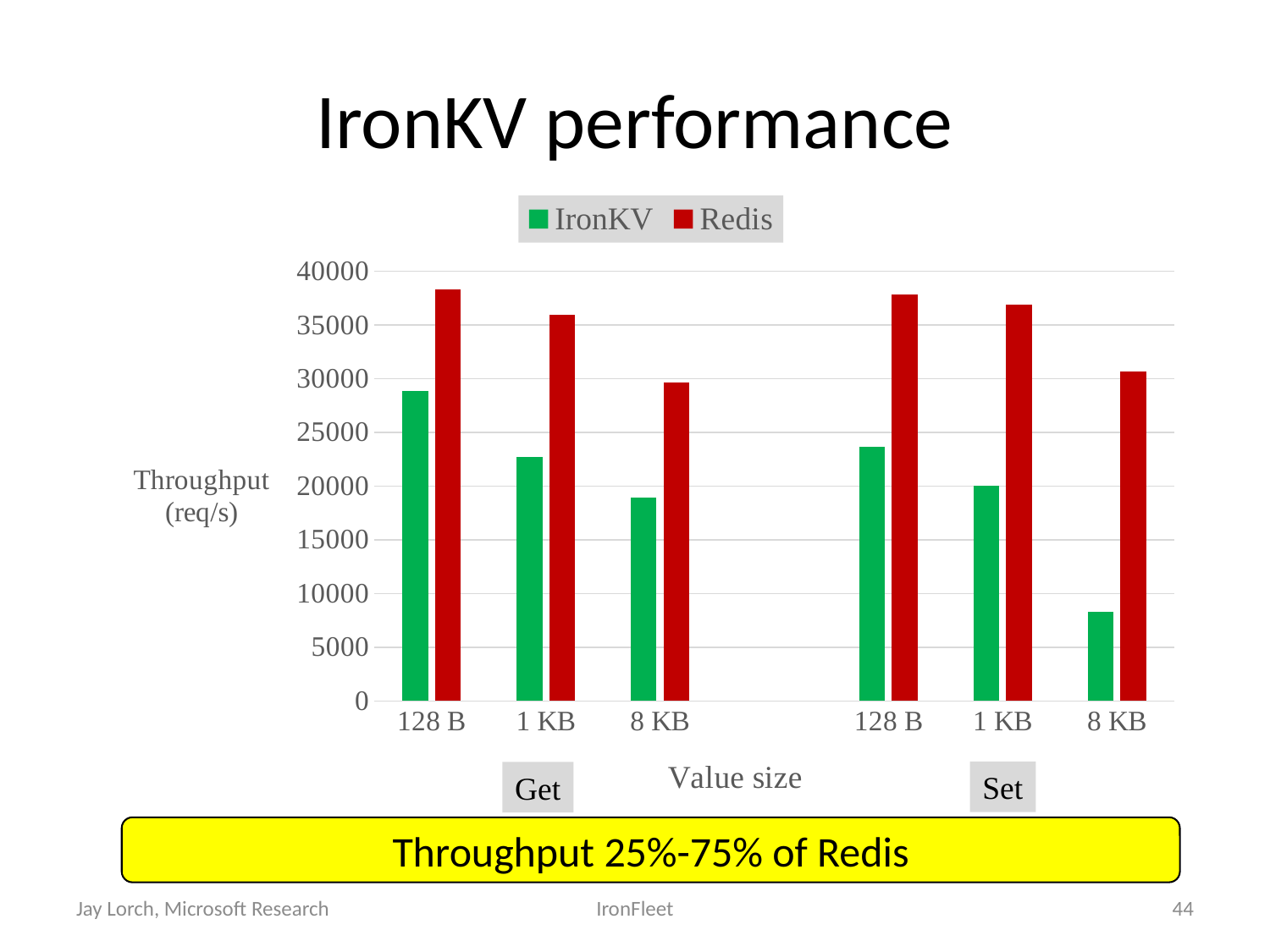
For Get at 1 KB, which is larger, IronKV or Redis? Redis What is the y-axis label of the chart? Throughput (req/s) Is the IronKV value for Get at 8 KB greater or less than 20000? less Is the IronKV value for Set at 8 KB greater or less than 10000? less Which category has the highest IronKV throughput? Get 128 B Which category has the lowest IronKV throughput? Set 8 KB How many series does the legend list? 2 How many value-size categories are plotted in the chart (across both Get and Set)? 6 Is the Redis value for Get at 128 B greater or less than 35000? greater What kind of chart is shown on the slide? bar chart Which two series are listed in the legend? IronKV and Redis